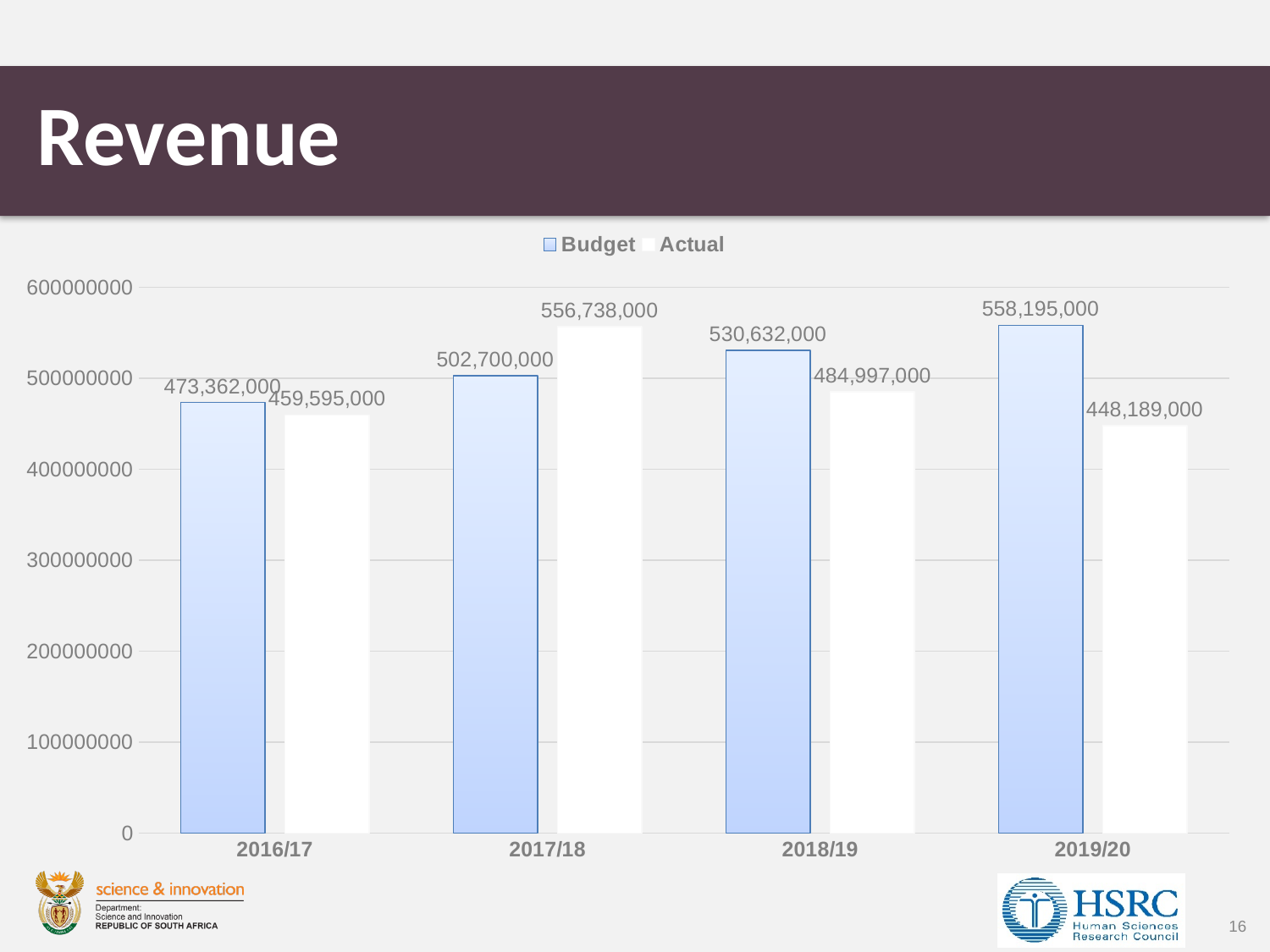
What is the difference between Budget and Actual in 2019/20? 110,006,000 In which year is the Actual revenue highest? 2017/18 Do the Budget values rise or fall from 2016/17 to 2019/20? rise By how much does Actual exceed Budget in 2017/18? 54,038,000 In which year is the Budget value highest? 2019/20 In which year is the Actual revenue lowest? 2019/20 What kind of chart is shown on the slide? bar chart How many series does the legend list? 2 What is the Actual value for 2018/19? 484,997,000 In 2018/19, which is larger, Budget or Actual? Budget What is the Actual value for 2019/20? 448,189,000 What is the Budget value for 2017/18? 502,700,000